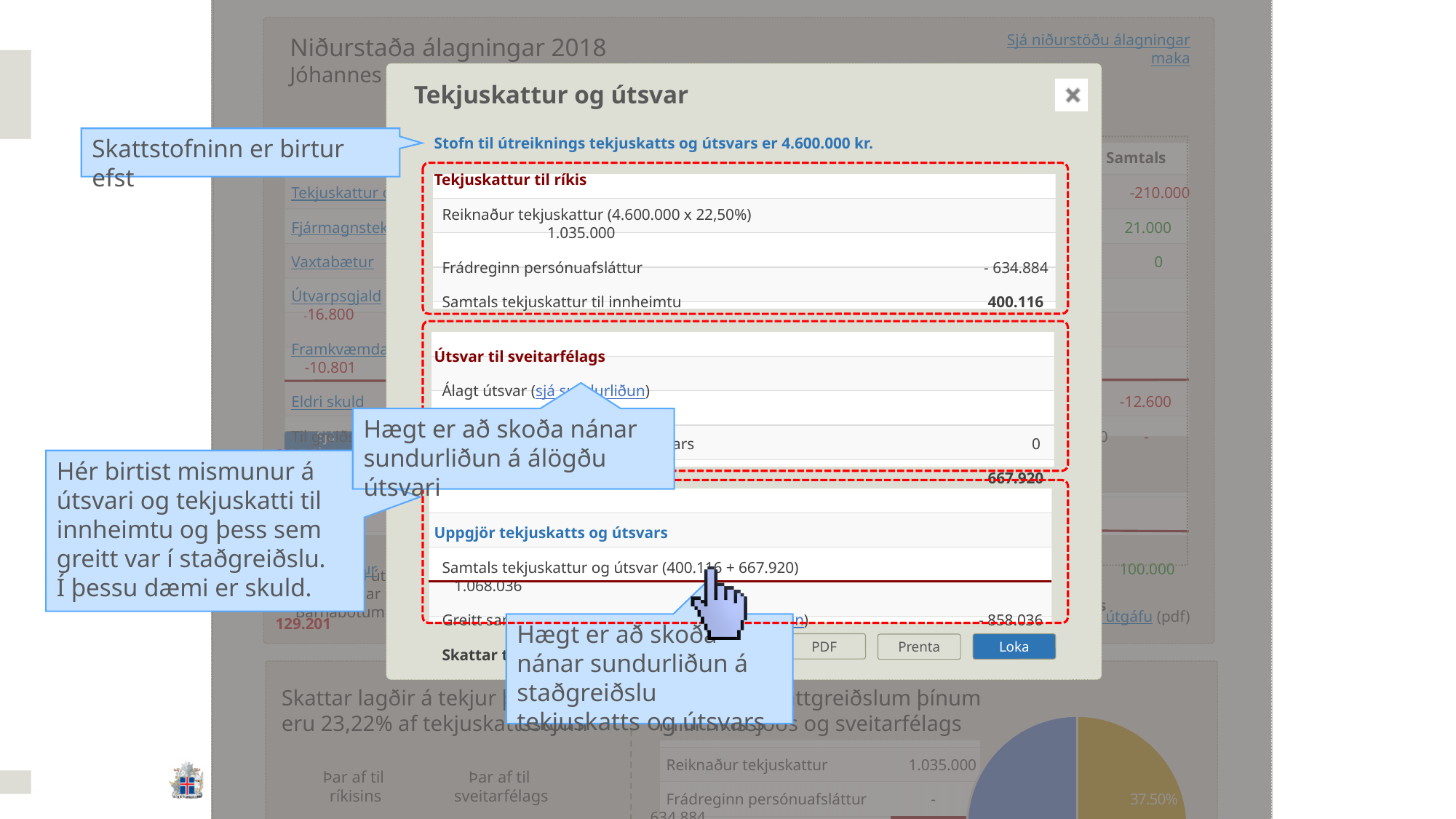
What kind of chart is partially visible in the bottom right corner of the slide? pie chart In the pie chart at the bottom right, is the gold slice's share greater or less than 50%? less In the pie chart at the bottom right, which slice is larger, the blue-grey slice or the gold slice? the blue-grey slice In the pie chart at the bottom right, what percentage label is printed on the gold slice? 37,50%